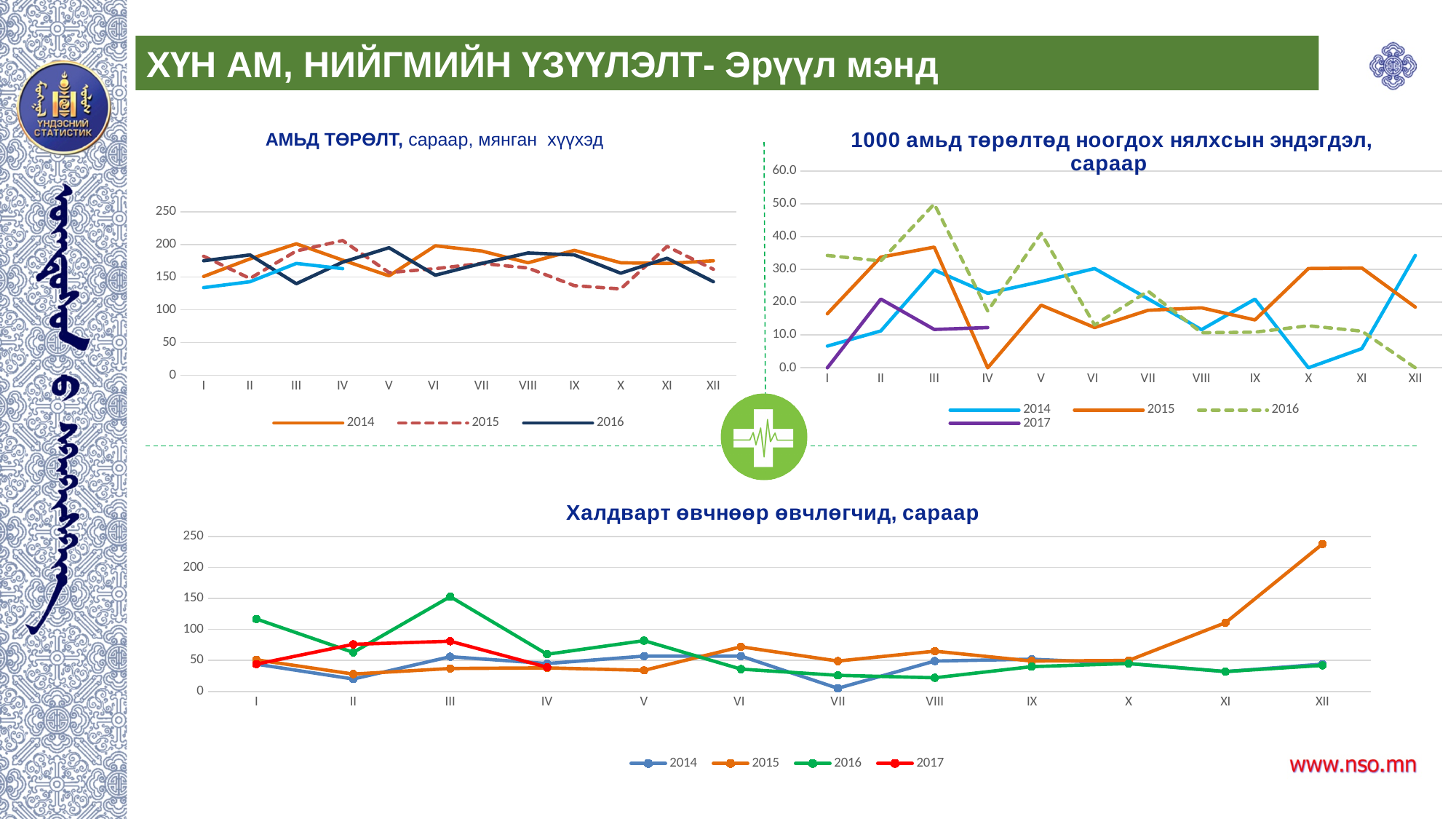
In the bottom chart 'Халдварт өвчнөөр өвчлөгчид, сараар', how many months are shown on the x axis? 12 In the top-right chart '1000 амьд төрөлтөд ноогдох нялхсын эндэгдэл, сараар', is the value for 2016 in month III greater or less than 40.0? greater In the bottom chart 'Халдварт өвчнөөр өвчлөгчид, сараар', is the value for 2014 in month VII greater or less than 50? less In the top-left chart 'АМЬД ТӨРӨЛТ, сараар, мянган хүүхэд', which series is drawn with a dashed line? 2015 In the top-left chart 'АМЬД ТӨРӨЛТ, сараар, мянган хүүхэд', is the value for 2015 in month X greater or less than 150? less In the bottom chart 'Халдварт өвчнөөр өвчлөгчид, сараар', in which month does the 2016 series reach its highest value? III In the top-right chart '1000 амьд төрөлтөд ноогдох нялхсын эндэгдэл, сараар', in which month does the 2014 series reach its lowest value? X What kind of chart is the chart titled 'Халдварт өвчнөөр өвчлөгчид, сараар' at the bottom of the slide? line chart In the bottom chart 'Халдварт өвчнөөр өвчлөгчид, сараар', in which month does the 2015 series reach its highest value? XII In the top-right chart '1000 амьд төрөлтөд ноогдох нялхсын эндэгдэл, сараар', how many series does the legend list? 4 In the top-left chart 'АМЬД ТӨРӨЛТ, сараар, мянган хүүхэд', how many series does the legend list? 3